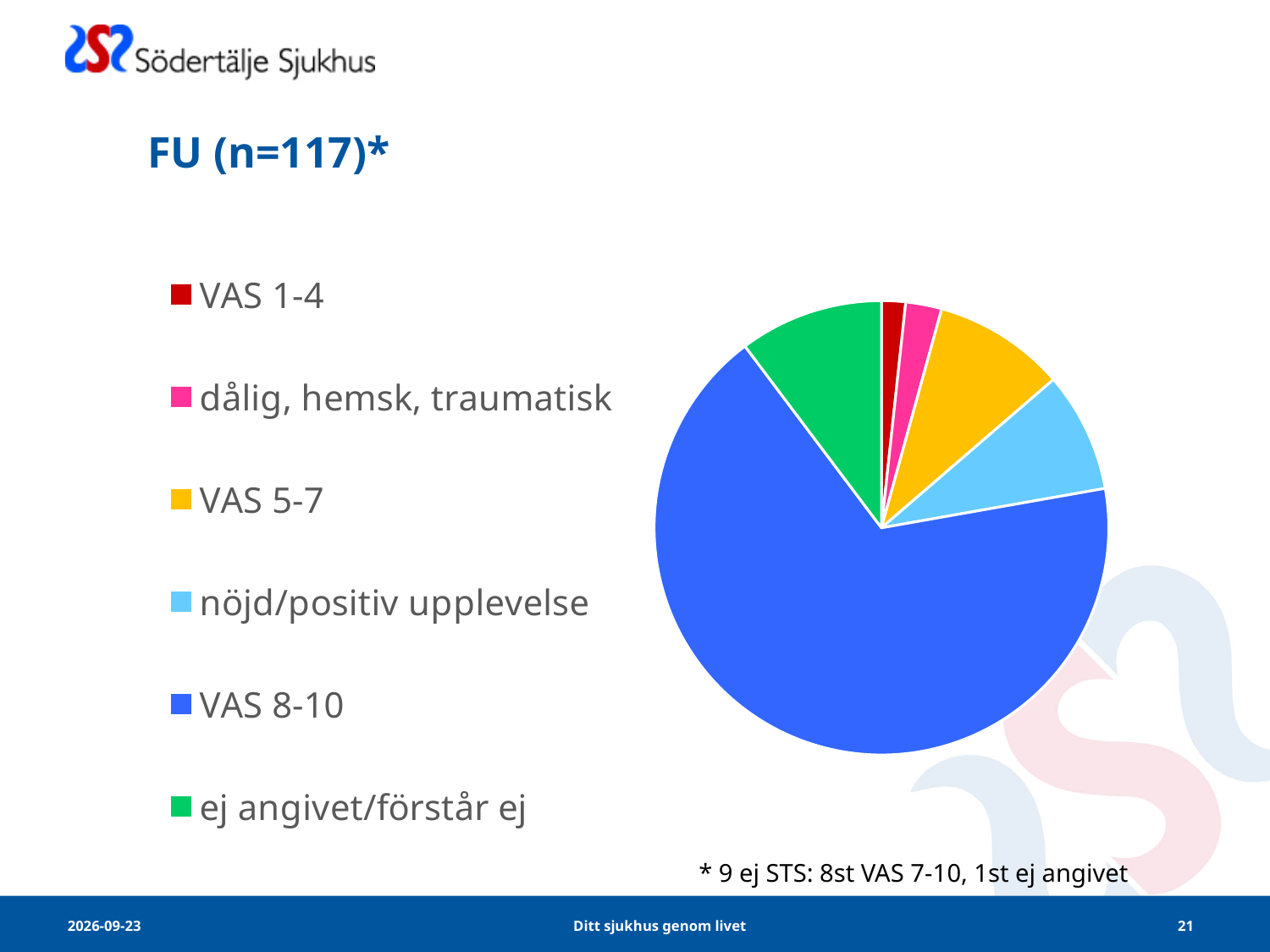
Which slice is larger, VAS 5-7 or dålig, hemsk, traumatisk? VAS 5-7 Which slice is larger, ej angivet/förstår ej or VAS 1-4? ej angivet/förstår ej Which slice is larger, VAS 8-10 or VAS 5-7? VAS 8-10 Which category has the largest slice of the pie? VAS 8-10 What kind of chart is shown on the slide? pie chart How many categories does the legend of the pie chart list? 6 Does the VAS 8-10 slice take up more or less than half of the pie? more What is the title of the chart? FU (n=117)* What colour is the VAS 8-10 slice in the pie chart? blue Which category has the smallest slice of the pie? VAS 1-4